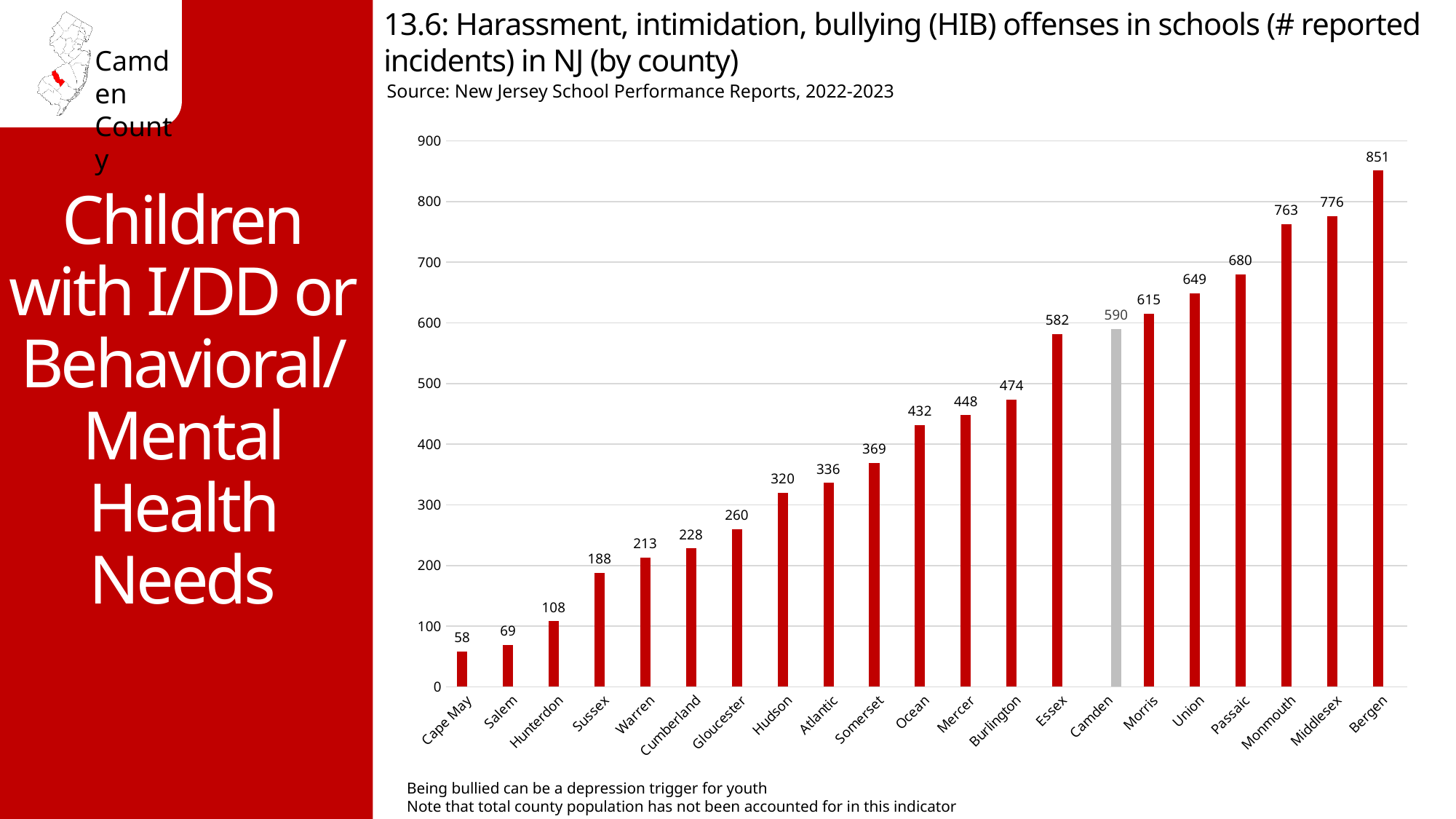
What is the number of reported HIB incidents for Camden County? 590 Which county has more reported HIB incidents, Monmouth or Passaic? Monmouth What is the difference in reported HIB incidents between Bergen and Camden? 261 What is the number of reported HIB incidents for Gloucester County? 260 Which county's bar is shown in gray instead of red? Camden Is the value for Hudson greater or less than 300? greater What is the number of reported HIB incidents for Bergen County? 851 How many counties are shown on the chart? 21 What is the difference in reported HIB incidents between Essex and Burlington? 108 Which county has the lowest number of reported HIB incidents? Cape May Which county has the highest number of reported HIB incidents? Bergen What kind of chart is used to show HIB incidents by county? Bar chart